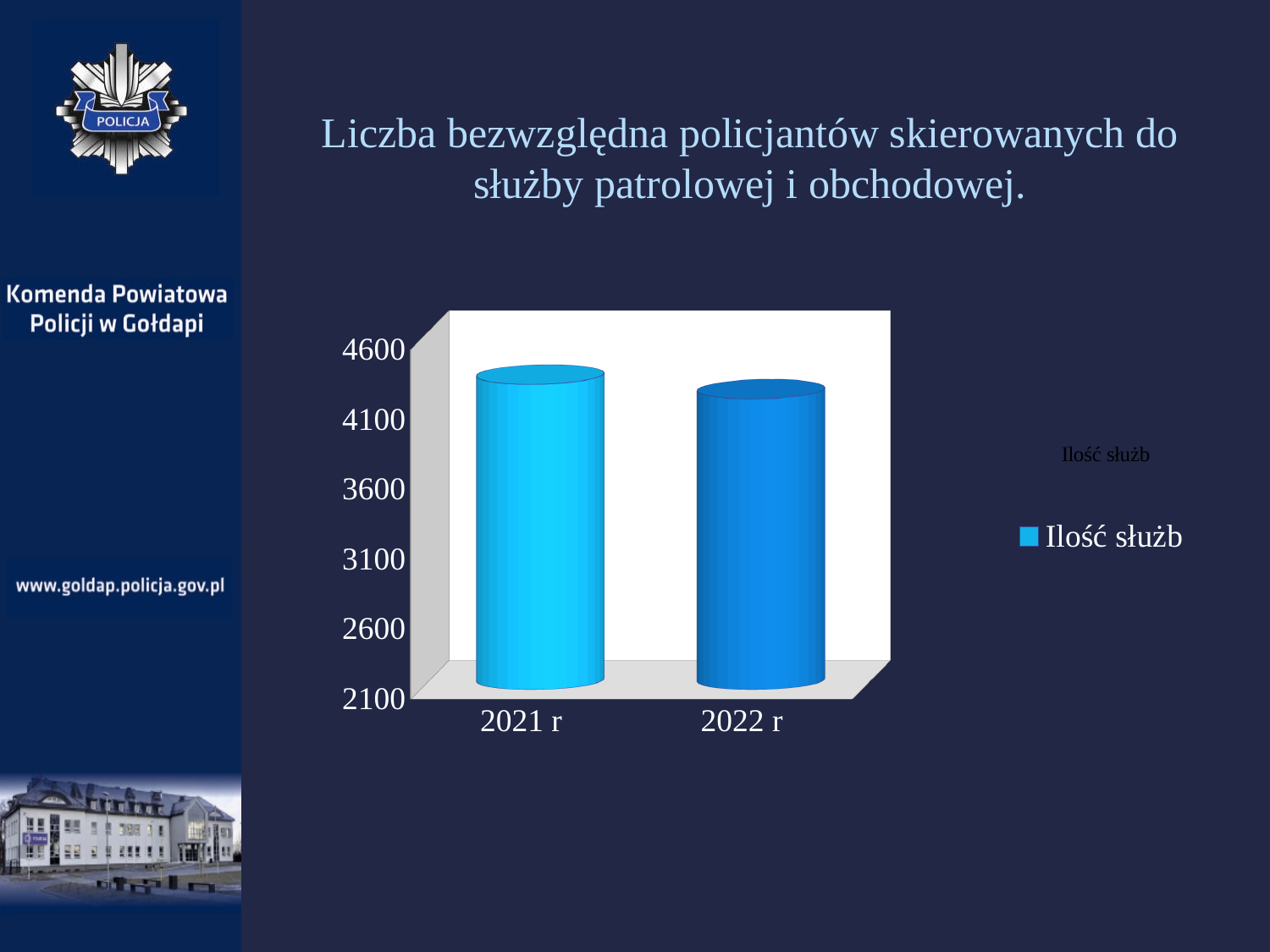
Which year has the highest value in the chart? 2021 r Which is larger, the value for 2021 r or the value for 2022 r? 2021 r Is the value for 2021 r greater or less than 4100? greater Is the value for 2022 r greater or less than 3600? greater What series name is shown in the chart legend? Ilość służb How many series does the chart legend list? 1 Which year has the lowest value in the chart? 2022 r Is the value for 2022 r greater or less than 4100? greater How many categories are shown on the x axis of the chart? 2 Do the values rise or fall from 2021 r to 2022 r? fall What kind of chart is shown on the slide? bar chart